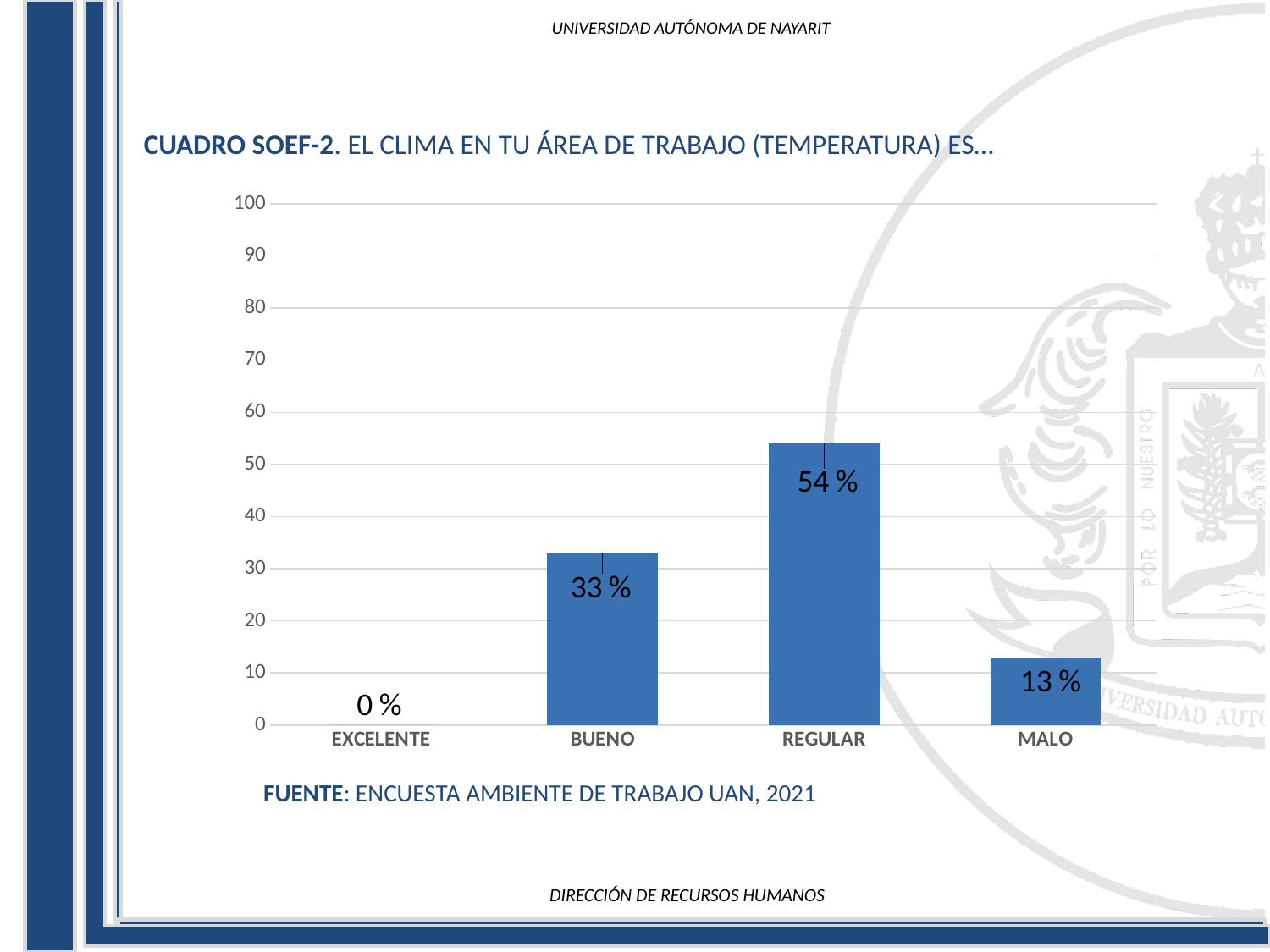
What kind of chart is shown on the slide? bar chart Which category has the highest value? REGULAR What is the difference between the values for REGULAR and BUENO? 21 % Is the value for REGULAR greater or less than 50? greater What is the value for BUENO? 33 % What is the value for MALO? 13 % What is the value for REGULAR? 54 % Which category has the lowest value? EXCELENTE Which is larger, the value for BUENO or the value for MALO? BUENO What is the value for EXCELENTE? 0 % What is the source cited below the chart? ENCUESTA AMBIENTE DE TRABAJO UAN, 2021 How many categories are shown on the x axis? 4